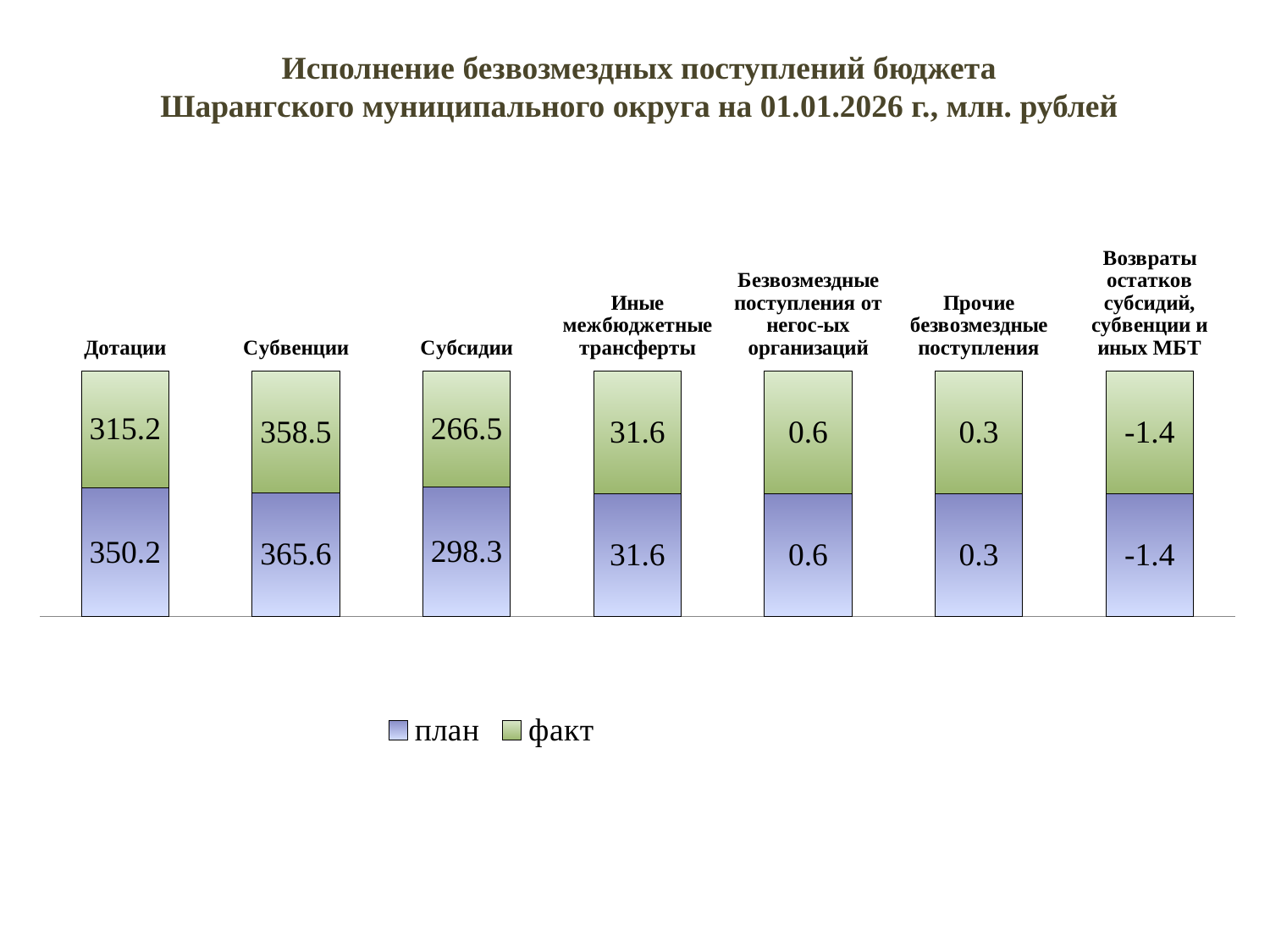
What is the план value for Дотации? 350.2 How many series does the legend list? 2 What is the план value for Иные межбюджетные трансферты? 31.6 What is the difference between the план and факт values for Дотации? 35.0 What kind of chart is shown on the slide? Stacked bar chart For Субвенции, which is larger: план or факт? план How many categories are shown on the chart? 7 What is the факт value for Субвенции? 358.5 Which category has the highest план value? Субвенции What is the difference between the план and факт values for Субсидии? 31.8 What is the факт value for Возвраты остатков субсидий, субвенции и иных МБТ? -1.4 What is the факт value for Субсидии? 266.5